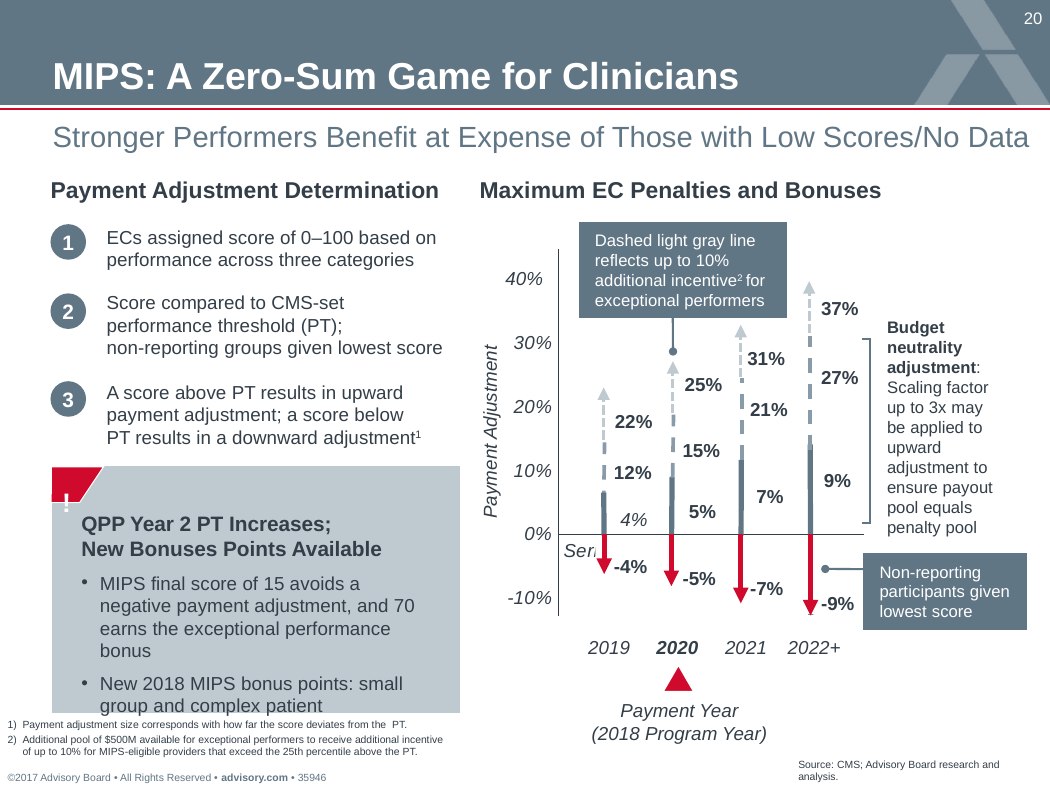
How many payment years are shown on the x axis of the Maximum EC Penalties and Bonuses chart? 4 In the Maximum EC Penalties and Bonuses chart, which payment year is highlighted in bold with a red triangle marker? 2020 In the Maximum EC Penalties and Bonuses chart, what is the highest percentage labeled for payment year 2020? 25% What is the label of the y axis in the Maximum EC Penalties and Bonuses chart? Payment Adjustment In the Maximum EC Penalties and Bonuses chart, what is the maximum penalty shown for payment year 2022+? -9% In the Maximum EC Penalties and Bonuses chart, which payment year has the largest maximum bonus? 2022+ In the Maximum EC Penalties and Bonuses chart, what is the highest percentage labeled for payment year 2021? 31% In the Maximum EC Penalties and Bonuses chart, what is the difference between the top labeled value for 2022+ (37%) and the top labeled value for 2019 (22%)? 15% In the Maximum EC Penalties and Bonuses chart, what is the maximum penalty shown for payment year 2019? -4% In the Maximum EC Penalties and Bonuses chart, is the maximum penalty larger in magnitude for 2021 or for 2020? 2021 In the Maximum EC Penalties and Bonuses chart, which payment year has the smallest maximum penalty? 2019 In the Maximum EC Penalties and Bonuses chart, do the maximum bonus values rise or fall from 2019 to 2022+? rise